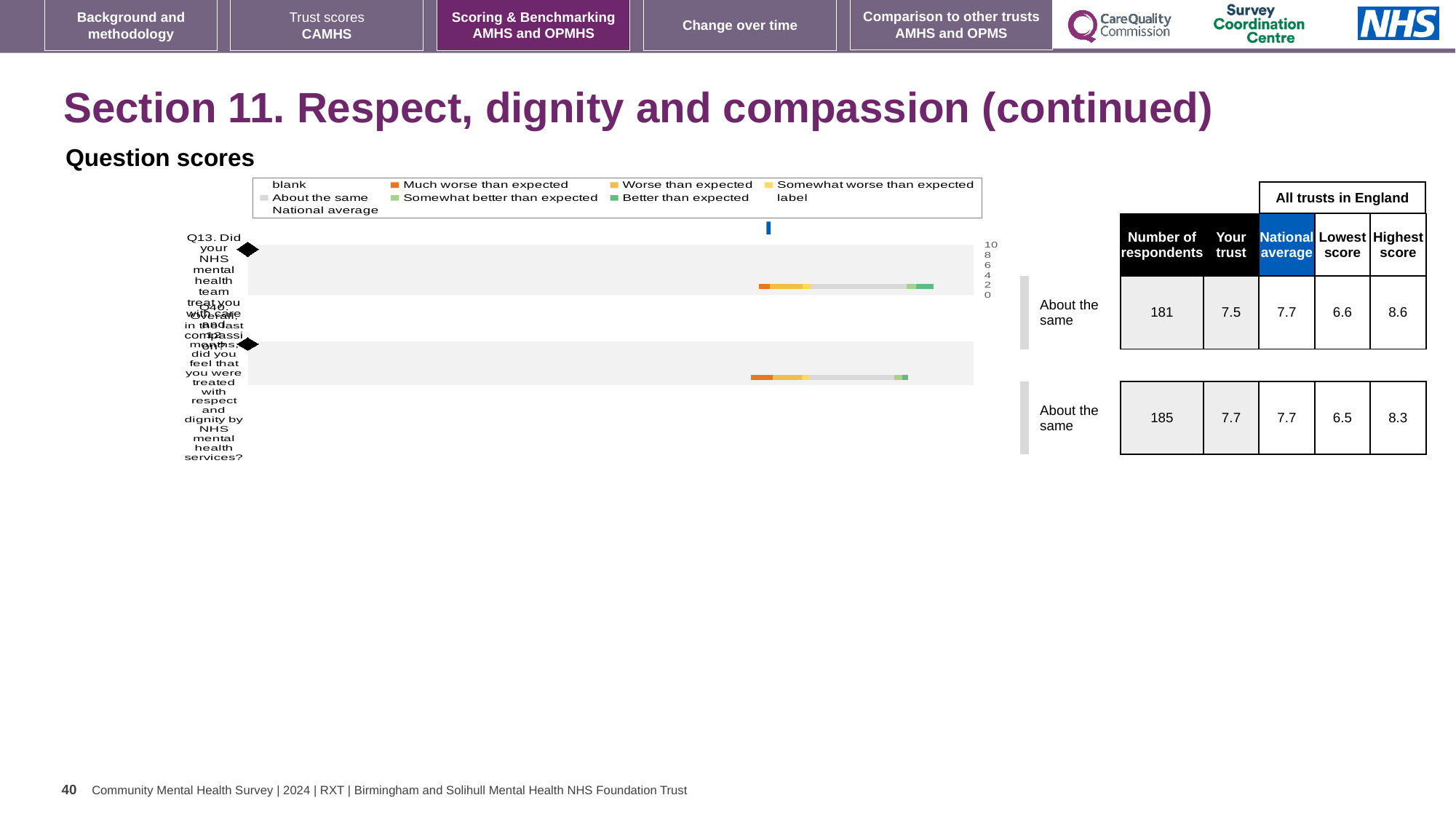
How many questions (categories) are plotted in the question scores chart? 2 What is the lowest score across all trusts in England for Q10? 6.5 What is the difference between the highest and lowest scores for Q13? 2.0 What is the national average score for Q10? 7.7 What is the difference between the highest and lowest scores for Q10? 1.8 What is the highest score across all trusts in England for Q13? 8.6 What benchmark category label is shown next to the Q13 bar? About the same Which question has more respondents, Q13 or Q10? Q10 For Q13, which is larger: the 'Your trust' score or the national average? National average What kind of chart is used to show the question scores on this slide? bar chart